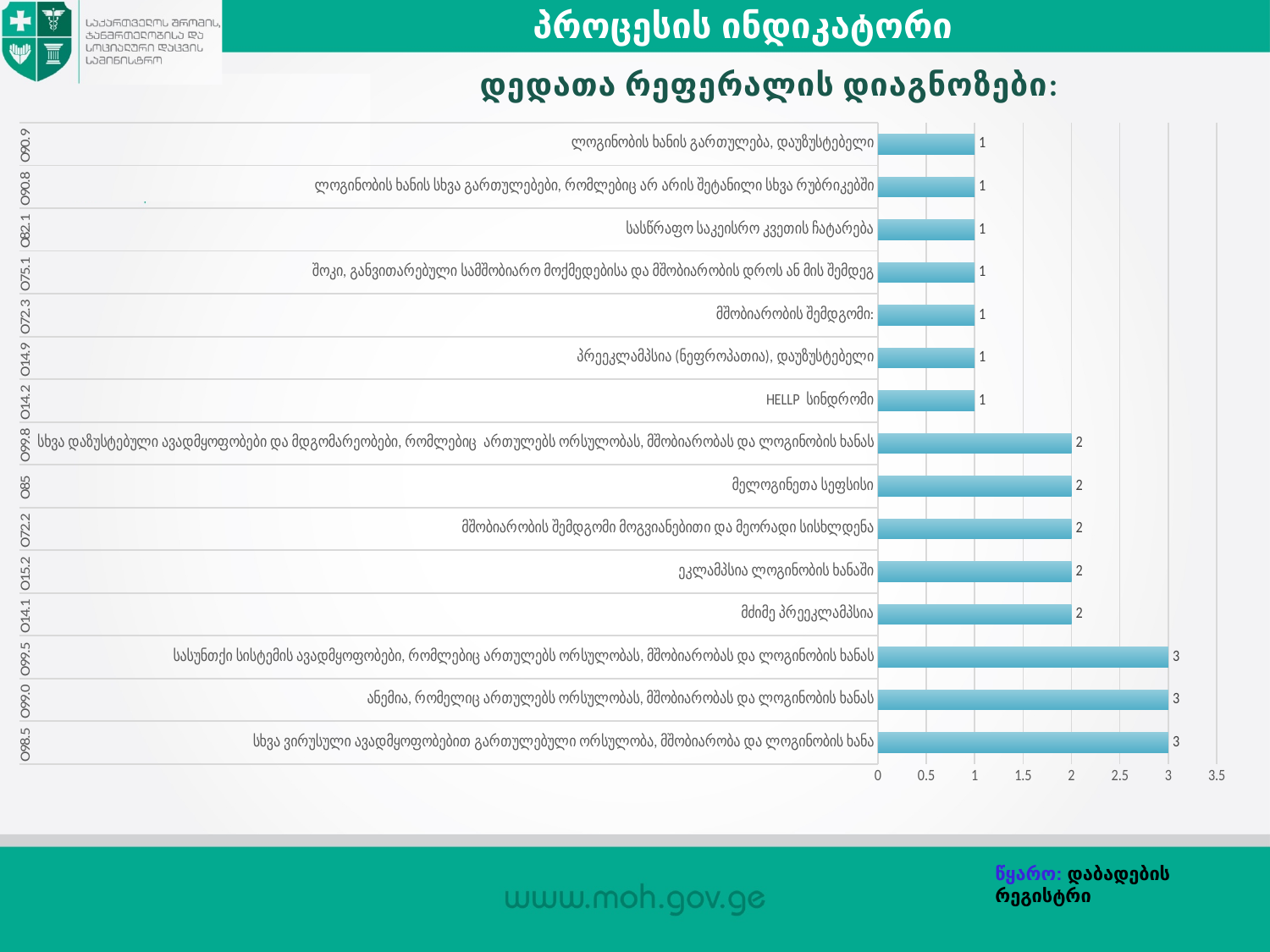
What is the difference between the values for O98.5 and O90.9? 2 Which has the larger value: O85 or O14.2? O85 What is the value for the category labelled O85 (მელოგინეთა სეფსისი)? 2 What is the value for HELLP სინდრომი (O14.2)? 1 What is the value for the category labelled O98.5? 3 What is the value for the category labelled O90.9? 1 What type of chart is shown on the slide? bar chart What is the title of the chart? დედათა რეფერალის დიაგნოზები: Is the value for O99.5 greater or less than 2.5? greater What is the lowest value shown in the chart? 1 What is the highest value shown in the chart? 3 How many categories (diagnoses) are plotted in the chart? 15